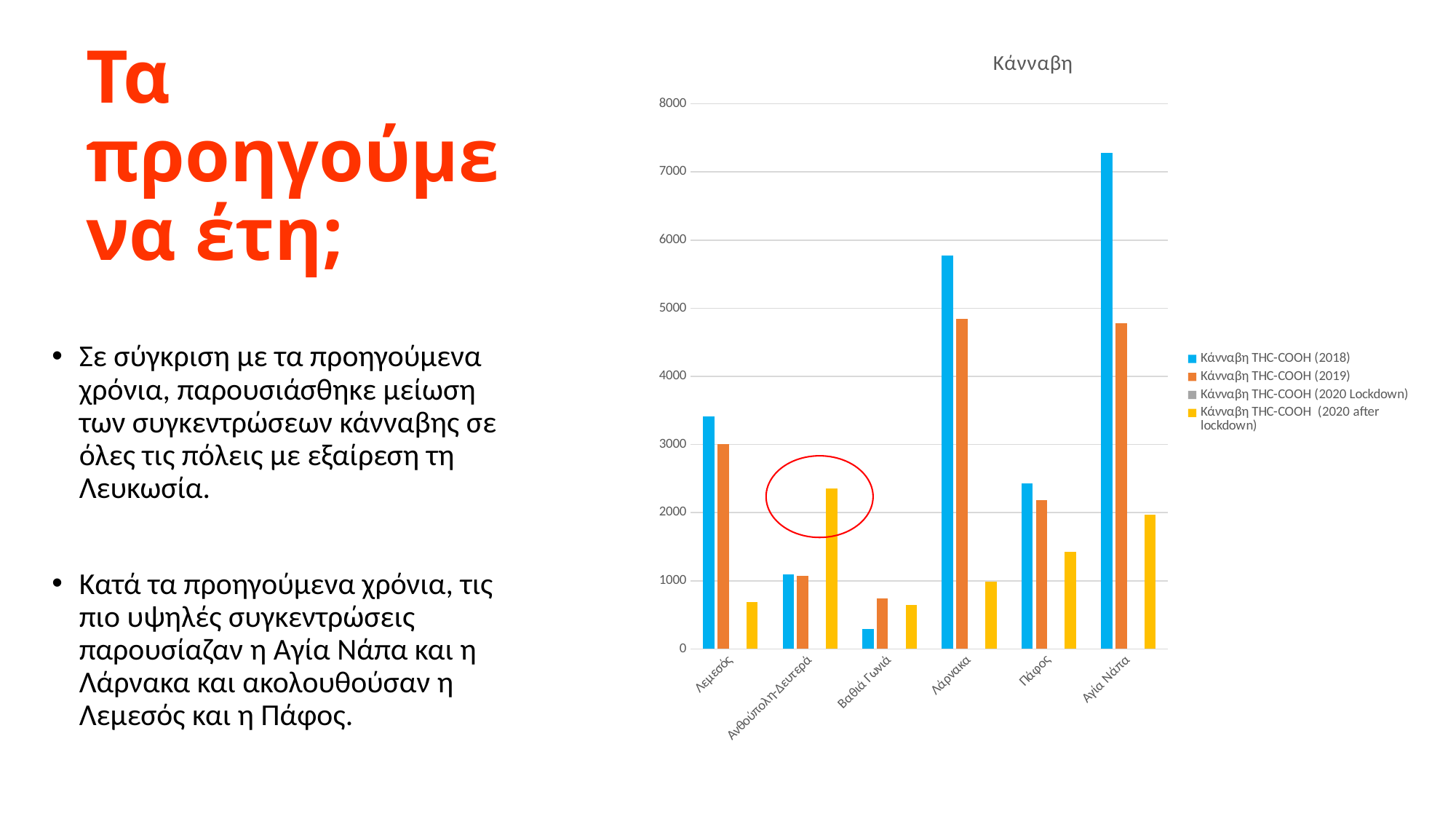
What kind of chart is shown on the slide? bar chart How many series does the legend list? 4 Is the Κάνναβη THC-COOH (2020 after lockdown) value for Ανθούπολη-Δευτερά greater or less than 2000? greater How many categories are shown on the x axis of the chart? 6 What is the title of the chart? Κάνναβη Is the Κάνναβη THC-COOH (2019) value for Λάρνακα greater or less than 5000? less Which category has the highest value for the Κάνναβη THC-COOH (2018) series? Αγία Νάπα Is the Κάνναβη THC-COOH (2018) value for Αγία Νάπα greater or less than 7000? greater Which is larger for the Κάνναβη THC-COOH (2018) series: Λάρνακα or Λεμεσός? Λάρνακα Which category has the lowest value for the Κάνναβη THC-COOH (2018) series? Βαθιά Γωνιά Which is larger for Πάφος: the Κάνναβη THC-COOH (2019) value or the Κάνναβη THC-COOH (2020 after lockdown) value? Κάνναβη THC-COOH (2019)